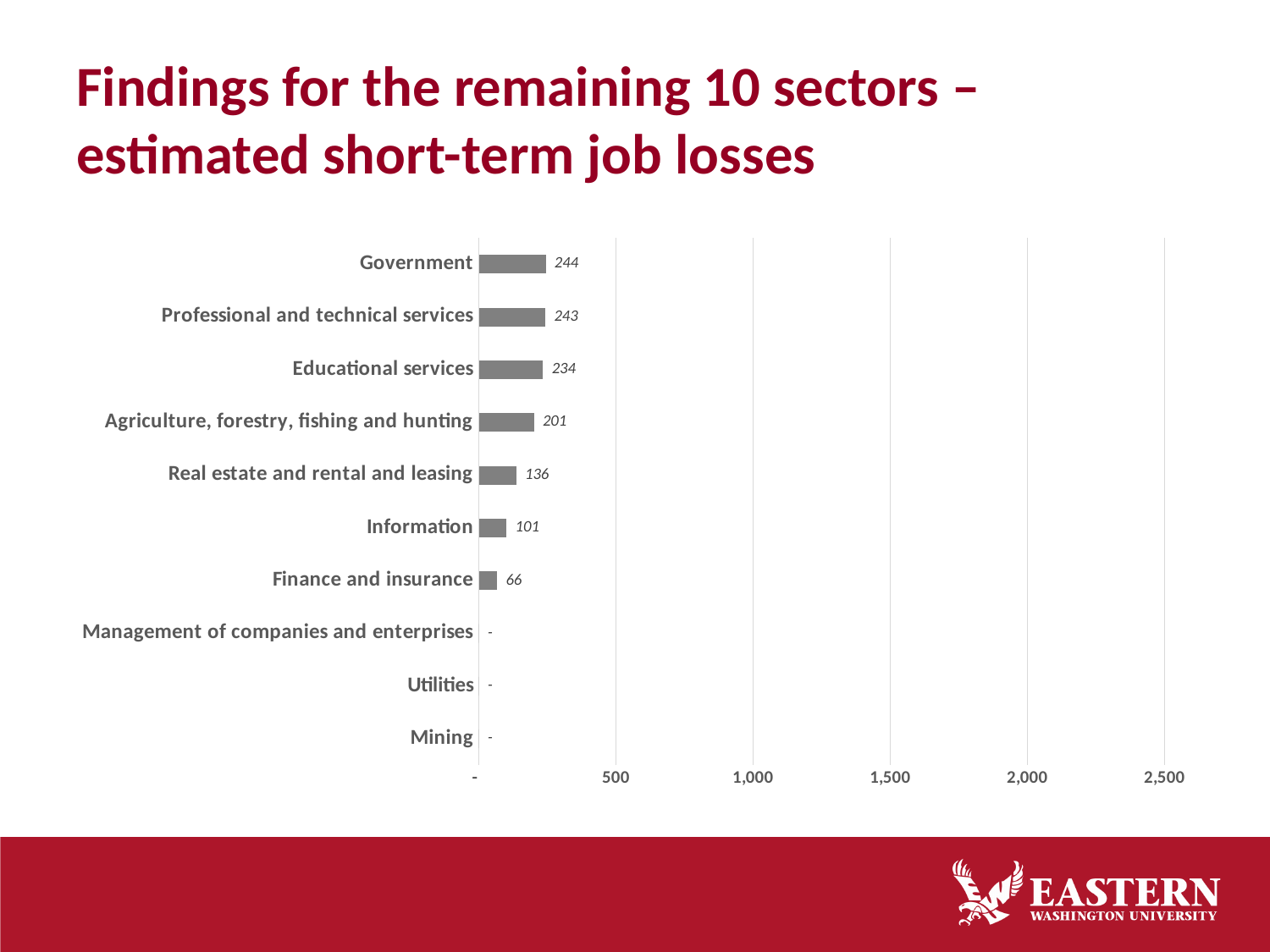
What is the highest value labelled on the horizontal axis? 2,500 Which sector has the highest estimated short-term job losses? Government What is the value shown for Agriculture, forestry, fishing and hunting? 201 What is the value shown for Real estate and rental and leasing? 136 What is the estimated short-term job loss for Government? 244 Is the value for Professional and technical services greater or less than 500? less What is the difference between the values for Government and Finance and insurance? 178 How many sectors are listed on the chart? 10 What is the value shown for Finance and insurance? 66 What is the difference between the values for Educational services and Information? 133 What kind of chart is shown on the slide? bar chart Which is larger, the value for Information or the value for Real estate and rental and leasing? Real estate and rental and leasing